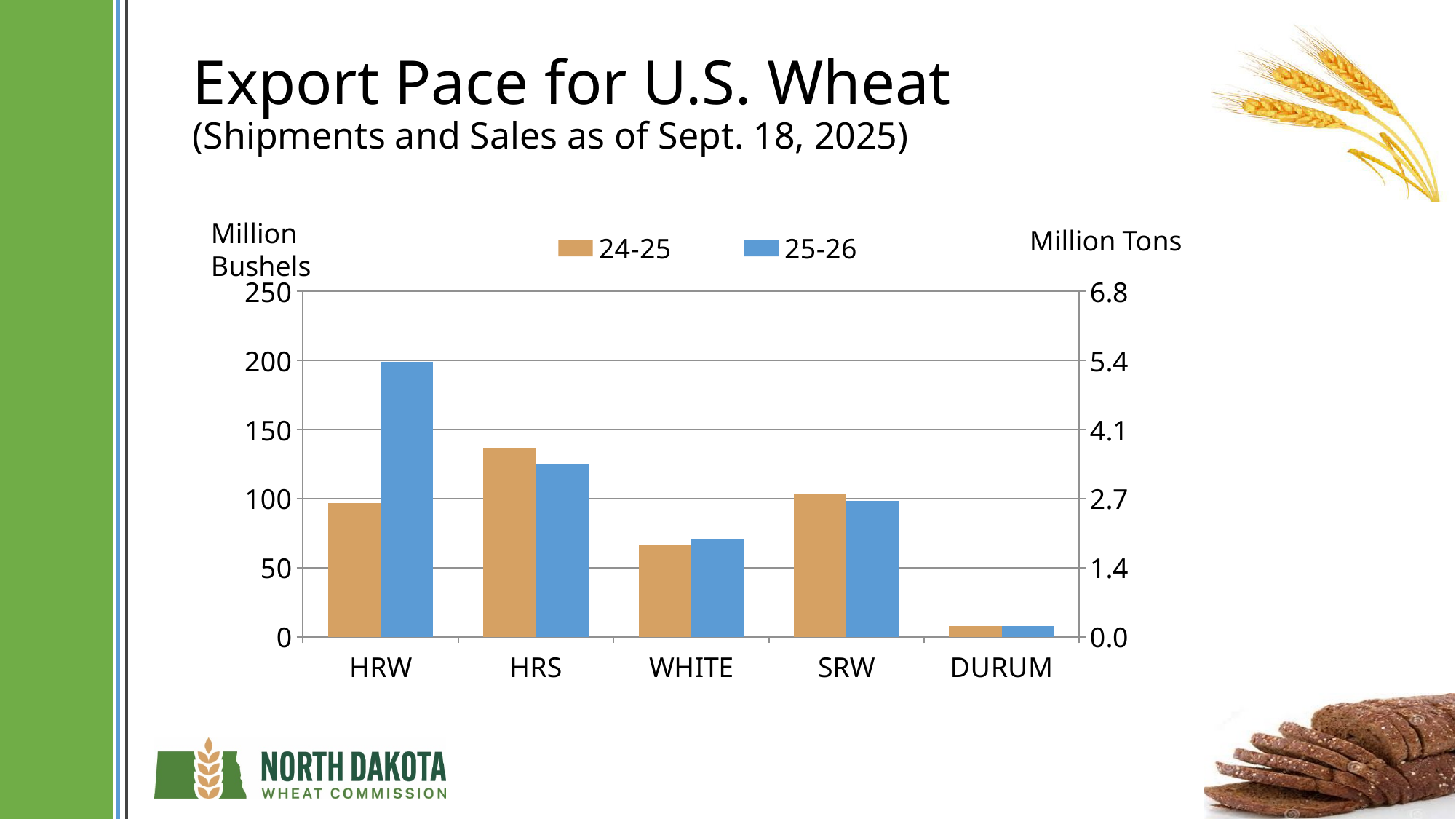
Which wheat class has the tallest 25-26 bar? HRW Which wheat class has the lowest values for both series? DURUM Is the 25-26 value for HRW greater or less than 150 million bushels? greater Is the 24-25 value for HRS greater or less than 100 million bushels? greater What unit is shown on the right-hand vertical axis? Million Tons How many series does the legend list? 2 How many wheat classes are shown on the x axis? 5 For HRS, which series has the larger value, 24-25 or 25-26? 24-25 What kind of chart is shown on the slide? bar chart For HRW, which series has the larger value, 24-25 or 25-26? 25-26 Is the 25-26 value for DURUM greater or less than 50 million bushels? less Which wheat class has the tallest 24-25 bar? HRS